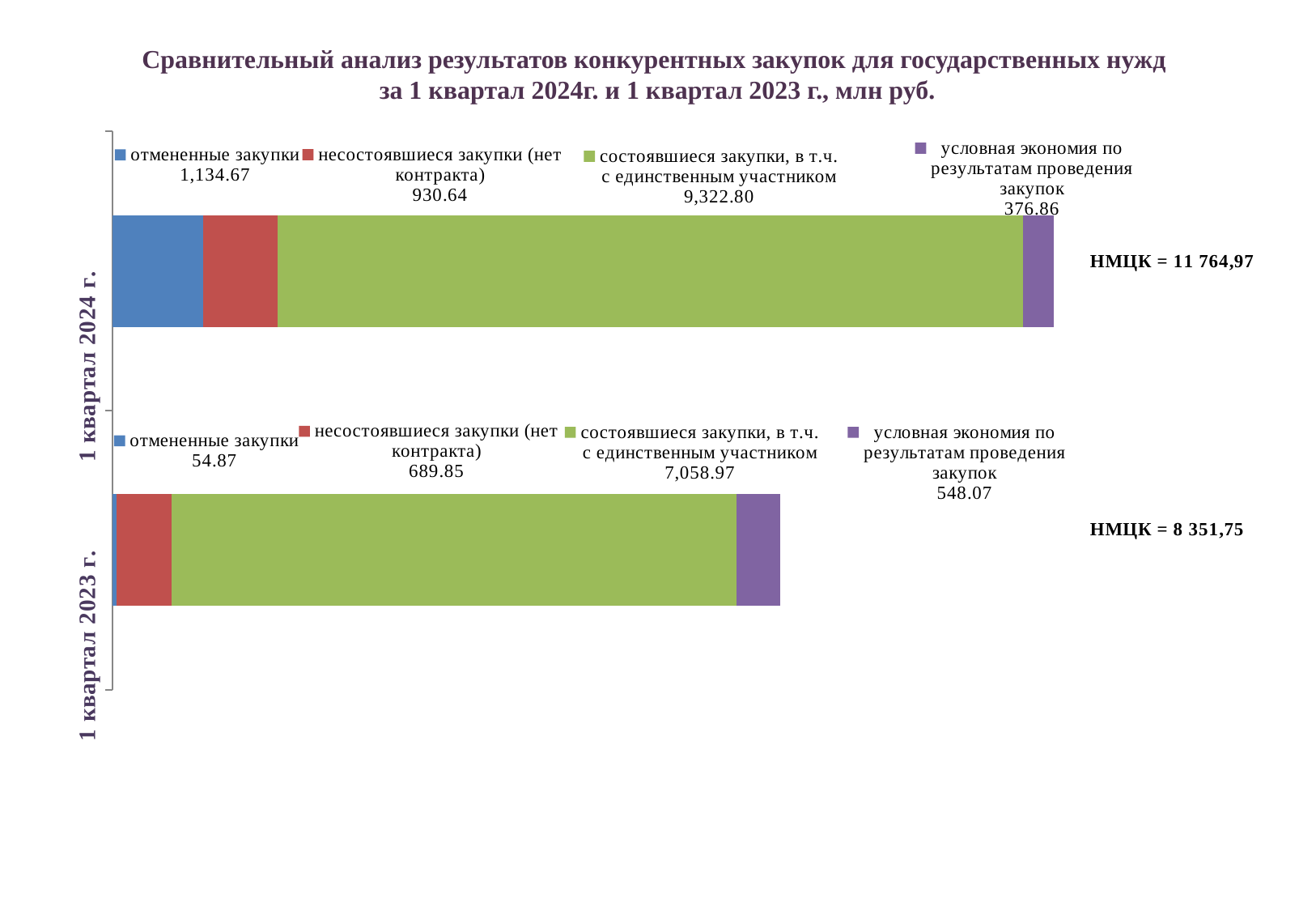
What is the value of отмененные закупки for 1 квартал 2024 г.? 1,134.67 What is the difference between состоявшиеся закупки, в т.ч. с единственным участником in 1 квартал 2024 г. and 1 квартал 2023 г.? 2,263.83 What is the value of несостоявшиеся закупки (нет контракта) for 1 квартал 2023 г.? 689.85 Which is larger: отмененные закупки in 1 квартал 2024 г. or in 1 квартал 2023 г.? 1 квартал 2024 г. Which segment is the largest in the bar for 1 квартал 2024 г.? состоявшиеся закупки, в т.ч. с единственным участником What is the value of состоявшиеся закупки, в т.ч. с единственным участником for 1 квартал 2023 г.? 7,058.97 What is the value of условная экономия по результатам проведения закупок for 1 квартал 2024 г.? 376.86 How many series are shown in the legend for each bar? 4 What НМЦК value is shown next to the bar for 1 квартал 2023 г.? 8 351,75 What kind of chart is shown on the slide? stacked bar chart What is the difference between условная экономия по результатам проведения закупок in 1 квартал 2023 г. and 1 квартал 2024 г.? 171.21 Which segment is the smallest in the bar for 1 квартал 2023 г.? отмененные закупки